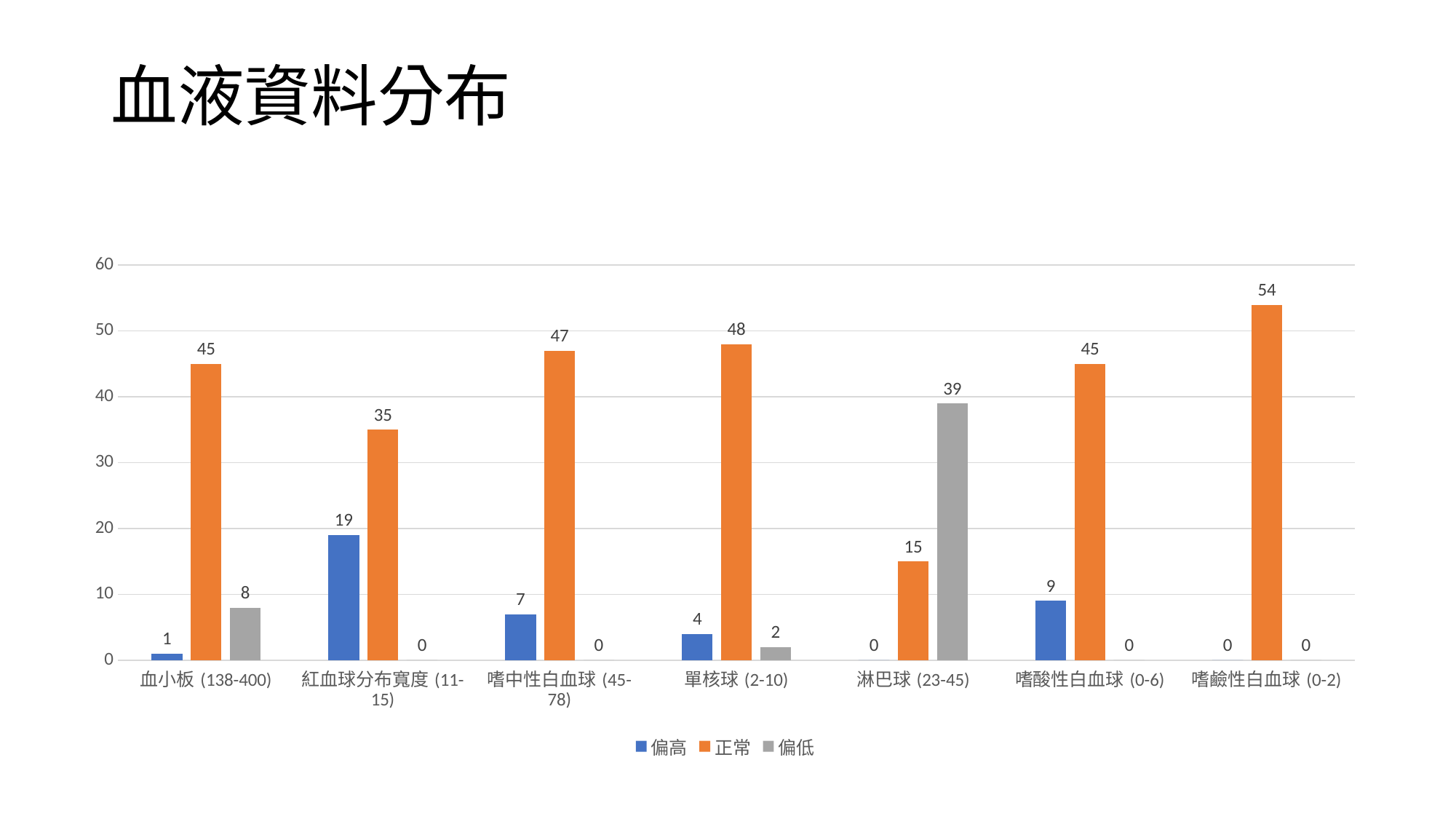
Is the 偏低 value for 淋巴球 (23-45) greater or less than 30? greater Which category has the lowest 正常 value? 淋巴球 (23-45) What is the 正常 value for 嗜鹼性白血球 (0-2)? 54 What is the 偏低 value for 淋巴球 (23-45)? 39 What is the 偏高 value for 紅血球分布寬度 (11-15)? 19 What is the difference between the 正常 value for 單核球 (2-10) and the 正常 value for 紅血球分布寬度 (11-15)? 13 What is the title of the slide? 血液資料分布 Which category has the highest 正常 value? 嗜鹼性白血球 (0-2) Which is larger: the 偏高 value for 嗜酸性白血球 (0-6) or the 偏高 value for 嗜中性白血球 (45-78)? 嗜酸性白血球 (0-6) How many categories are shown on the x axis? 7 How many series does the legend list? 3 What kind of chart is shown on the slide? bar chart